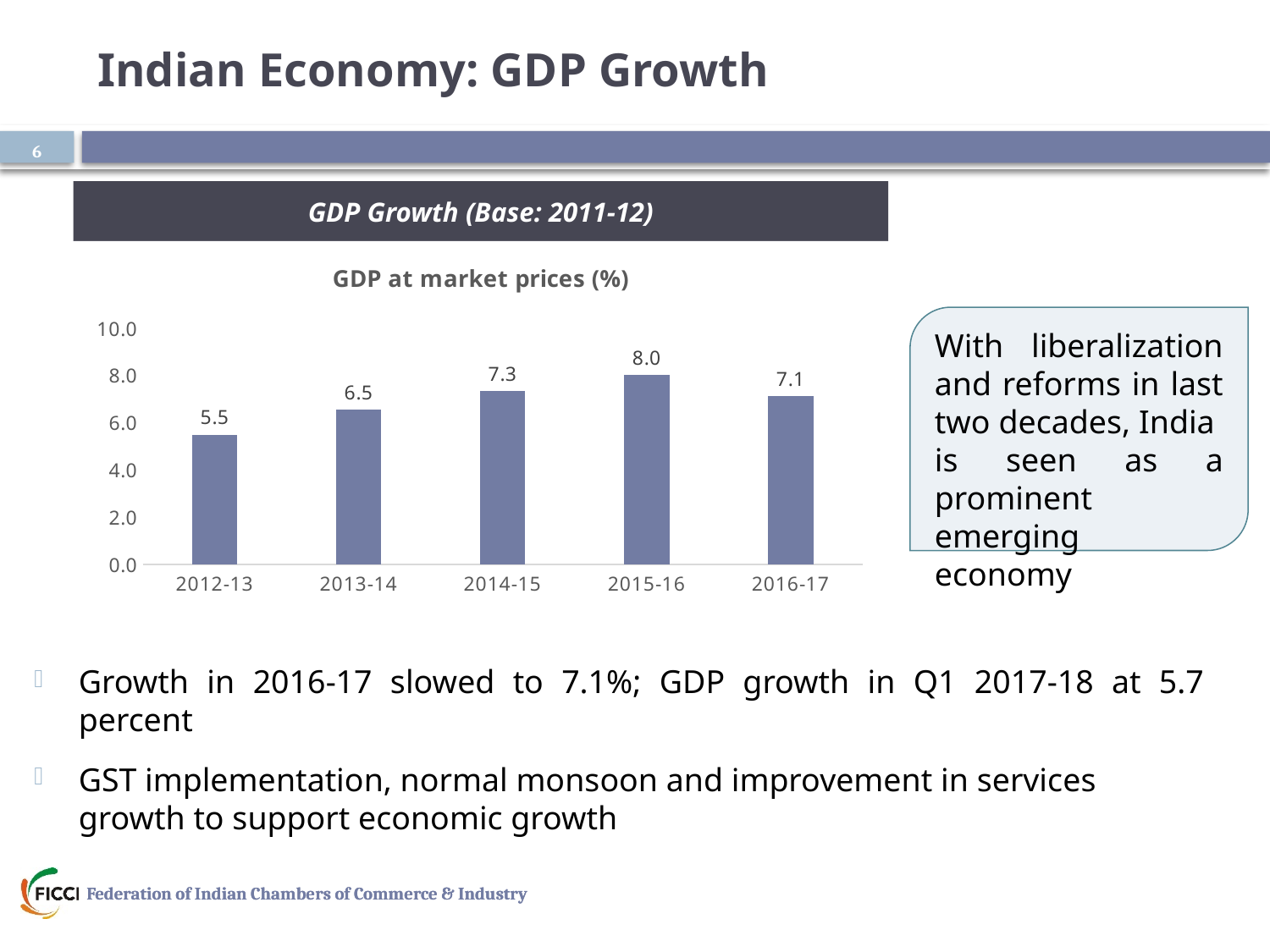
Which is larger, the GDP growth value for 2014-15 or for 2013-14? 2014-15 What is the difference between the GDP growth values for 2013-14 and 2012-13? 1.0 What is the GDP at market prices (%) value for 2015-16? 8.0 What kind of chart is used to show GDP at market prices (%)? bar chart Which year has the lowest GDP at market prices (%)? 2012-13 What is the GDP at market prices (%) value for 2012-13? 5.5 Which year has the highest GDP at market prices (%)? 2015-16 What is the title of the chart? GDP at market prices (%) What is the difference between the GDP growth values for 2015-16 and 2016-17? 0.9 What is the GDP at market prices (%) value for 2016-17? 7.1 Is the GDP growth value for 2012-13 greater or less than 6.0? less How many years are shown on the x axis of the chart? 5